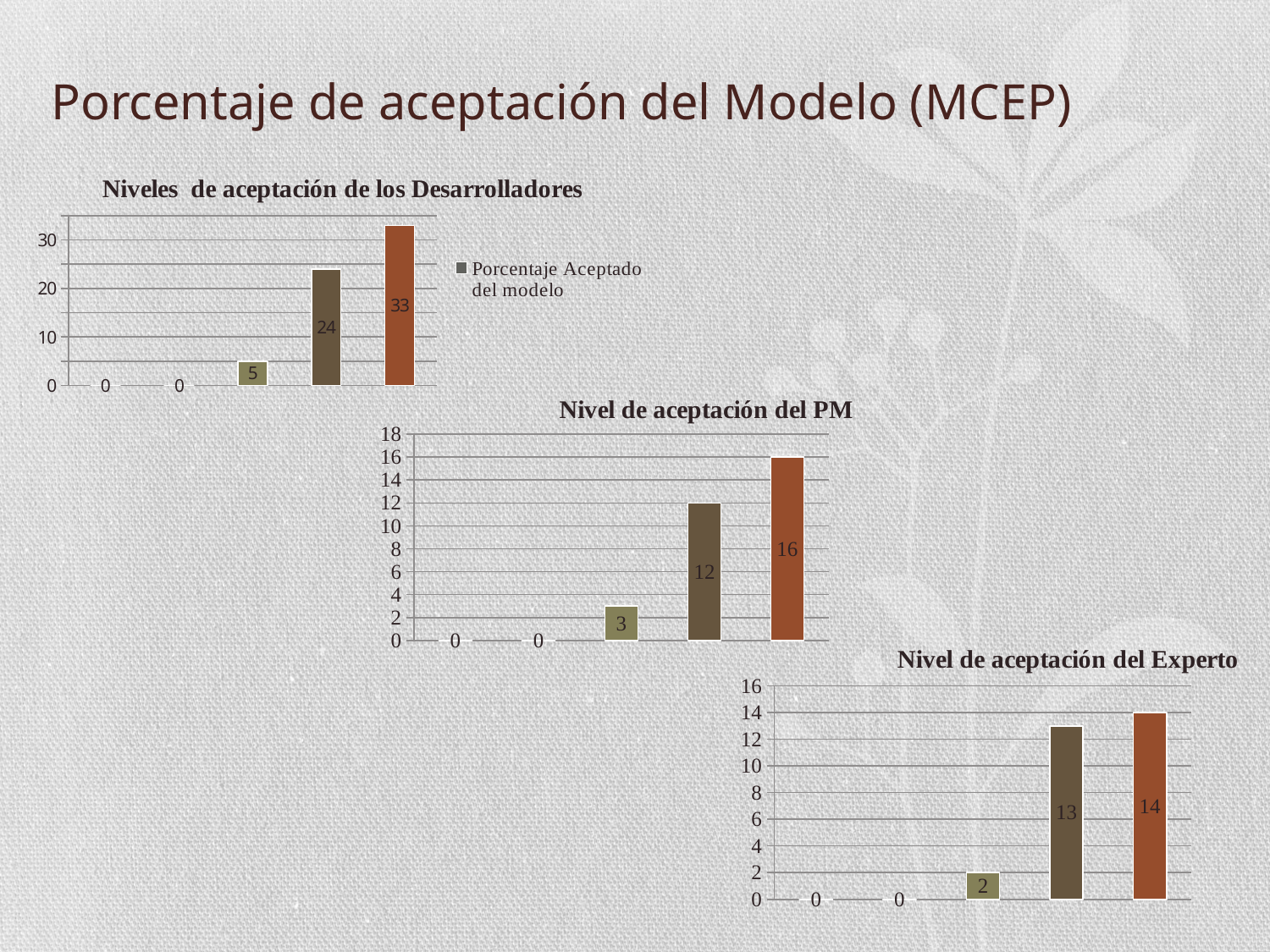
In the chart titled 'Nivel de aceptación del Experto', what is the value of the third bar from the left? 2 In the chart titled 'Niveles de aceptación de los Desarrolladores', what is the legend entry? Porcentaje Aceptado del modelo In the chart titled 'Niveles de aceptación de los Desarrolladores', how many series does the legend list? 1 In the chart titled 'Niveles de aceptación de los Desarrolladores', what is the highest value shown? 33 In the chart titled 'Nivel de aceptación del Experto', do the values rise or fall from left to right? rise In the chart titled 'Nivel de aceptación del PM', how many bars (categories) are plotted? 5 In the chart titled 'Nivel de aceptación del PM', what is the value of the rightmost bar? 16 In the chart titled 'Nivel de aceptación del Experto', what is the difference between the two tallest bars? 1 In the chart titled 'Nivel de aceptación del PM', which is larger: the fourth bar from the left or the rightmost bar? the rightmost bar In the chart titled 'Niveles de aceptación de los Desarrolladores', is the value of the rightmost bar greater or less than 30? greater In the chart titled 'Niveles de aceptación de los Desarrolladores', what is the difference between the rightmost bar and the bar immediately to its left? 9 In the chart titled 'Niveles de aceptación de los Desarrolladores', what kind of chart is shown? bar chart